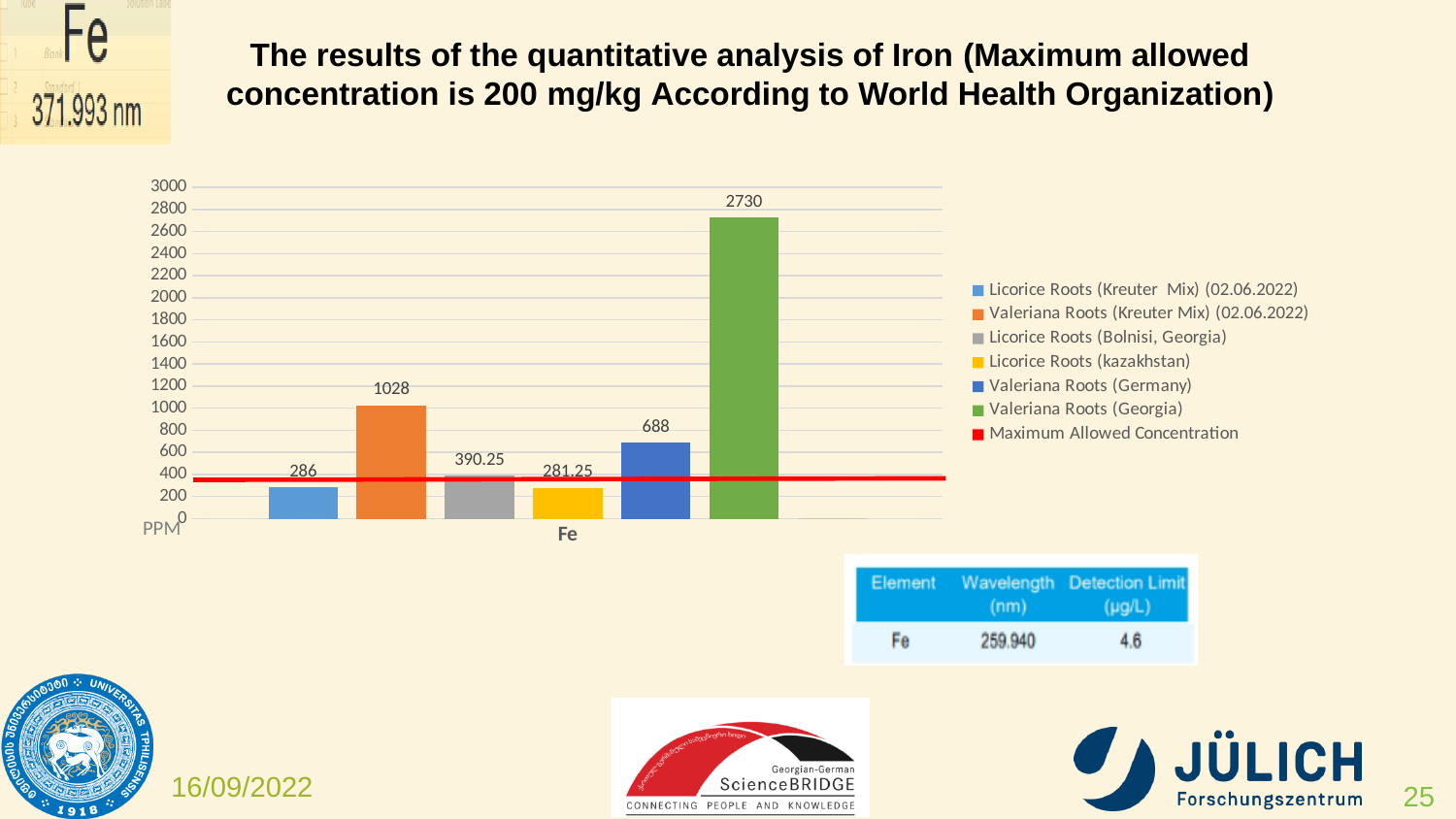
Which series has the highest value in the chart? Valeriana Roots (Georgia) What is the value for Licorice Roots (Bolnisi, Georgia) in the chart? 390.25 Which is larger: the value for Licorice Roots (Bolnisi, Georgia) or the value for Valeriana Roots (Germany)? Valeriana Roots (Germany) How many entries does the legend of the chart list? 7 What is the value for Valeriana Roots (Georgia) in the chart? 2730 What kind of chart is shown on the slide? bar chart Is the value for Valeriana Roots (Kreuter Mix) (02.06.2022) greater or less than 1000? greater Which series has the lowest value in the chart? Licorice Roots (kazakhstan) What is the difference between the values for Valeriana Roots (Georgia) and Valeriana Roots (Kreuter Mix) (02.06.2022)? 1702 What does the red horizontal line in the chart represent, according to the legend? Maximum Allowed Concentration What is the difference between the values for Valeriana Roots (Germany) and Licorice Roots (Kreuter Mix) (02.06.2022)? 402 What is the value for Valeriana Roots (Kreuter Mix) (02.06.2022) in the chart? 1028